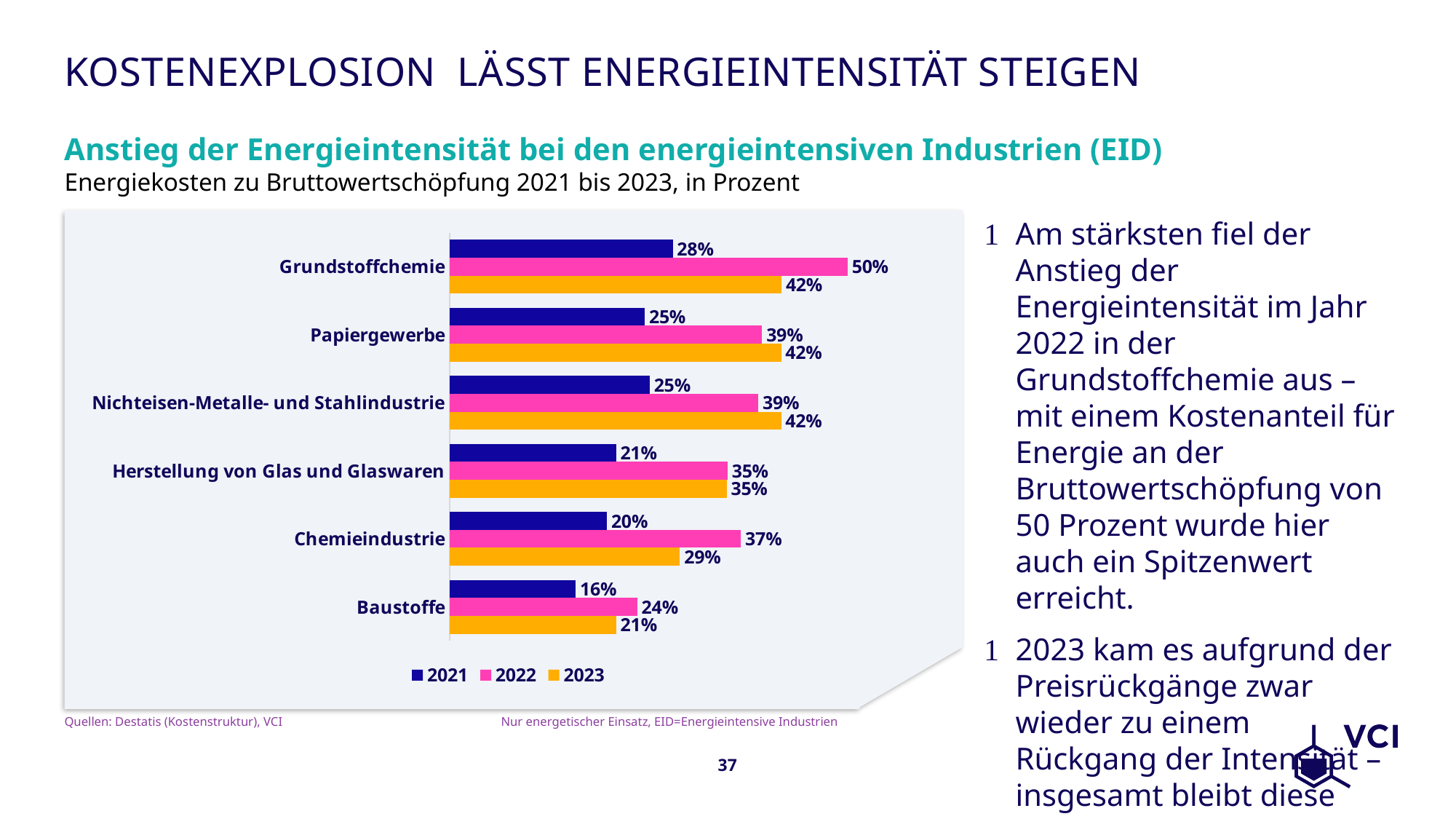
Which category has the lowest value in 2021? Baustoffe Which is larger for Chemieindustrie: the 2022 value or the 2023 value? 2022 Which colour represents the 2023 series in the legend? Orange What is the value for Grundstoffchemie in 2022? 50% What is the difference between the 2022 and 2021 values for Grundstoffchemie? 22% How many series does the legend list? 3 What is the difference between the 2023 values for Papiergewerbe and Baustoffe? 21% How many categories are shown on the chart? 6 What is the value for Baustoffe in 2021? 16% What kind of chart is shown on the slide? Bar chart Which category has the highest value in 2022? Grundstoffchemie What is the value for Chemieindustrie in 2023? 29%